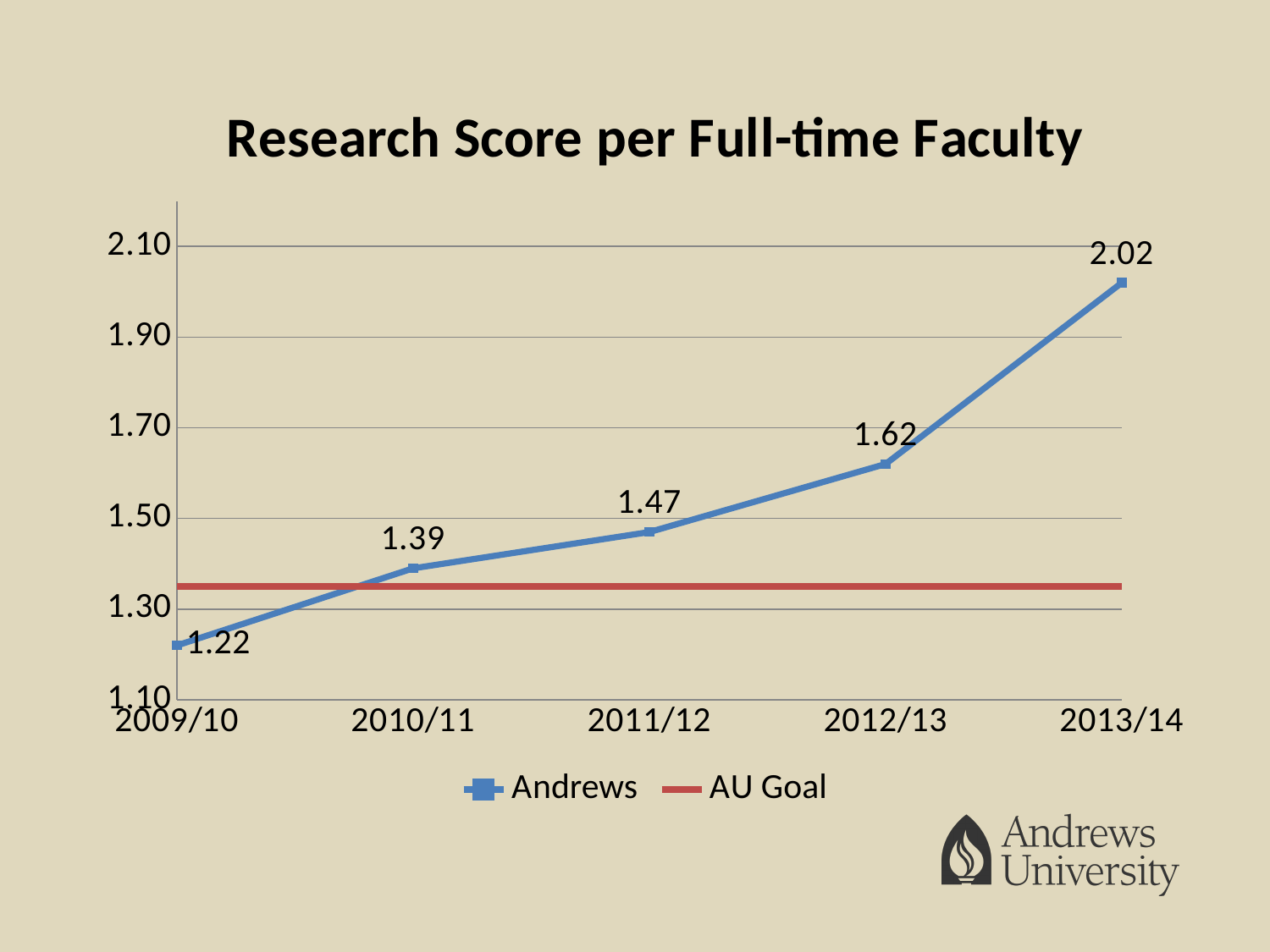
How many academic years are shown on the x axis? 5 What kind of chart is shown? line chart Which year has the highest Andrews research score? 2013/14 Do the Andrews values rise or fall from 2009/10 to 2013/14? rise What is the Andrews research score per full-time faculty for 2013/14? 2.02 What is the Andrews value for 2011/12? 1.47 Which year has the lowest Andrews research score? 2009/10 What is the Andrews value for 2009/10? 1.22 Is the AU Goal line greater or less than 1.50? less Which is larger, the Andrews value for 2010/11 or for 2011/12? 2011/12 What is the difference between the Andrews values for 2013/14 and 2012/13? 0.40 How many series does the legend list? 2